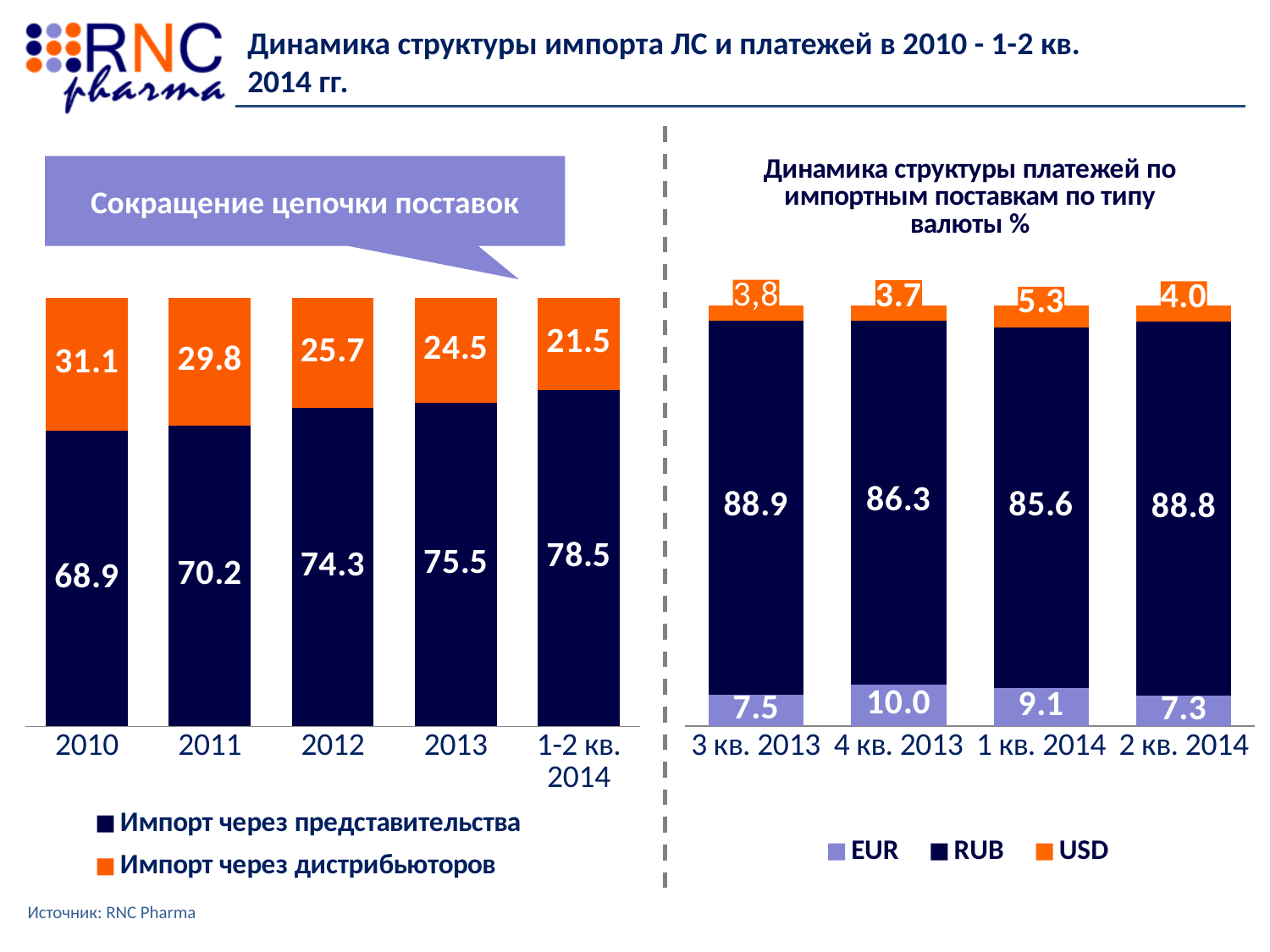
On the left chart, in which year is 'Импорт через дистрибьюторов' lowest? 1-2 кв. 2014 On the left chart, what is the value for 'Импорт через представительства' in 2012? 74.3 On the chart 'Динамика структуры платежей по импортным поставкам по типу валюты %', what is the USD value for 1 кв. 2014? 5.3 On the left chart, what is the difference between 'Импорт через представительства' in 1-2 кв. 2014 and in 2010? 9.6 On the chart 'Динамика структуры платежей по импортным поставкам по типу валюты %', which is larger: the EUR value for 3 кв. 2013 or for 2 кв. 2014? 3 кв. 2013 On the chart 'Динамика структуры платежей по импортным поставкам по типу валюты %', in which quarter is the EUR share highest? 4 кв. 2013 On the chart 'Динамика структуры платежей по импортным поставкам по типу валюты %', how many series does the legend list? 3 On the left chart, what is the value for 'Импорт через дистрибьюторов' in 2010? 31.1 What type of chart is the chart 'Динамика структуры платежей по импортным поставкам по типу валюты %'? stacked bar chart On the left chart, does 'Импорт через представительства' rise or fall from 2010 to 1-2 кв. 2014? rise On the chart 'Динамика структуры платежей по импортным поставкам по типу валюты %', what is the RUB value for 4 кв. 2013? 86.3 On the left chart, how many categories are shown on the x axis? 5